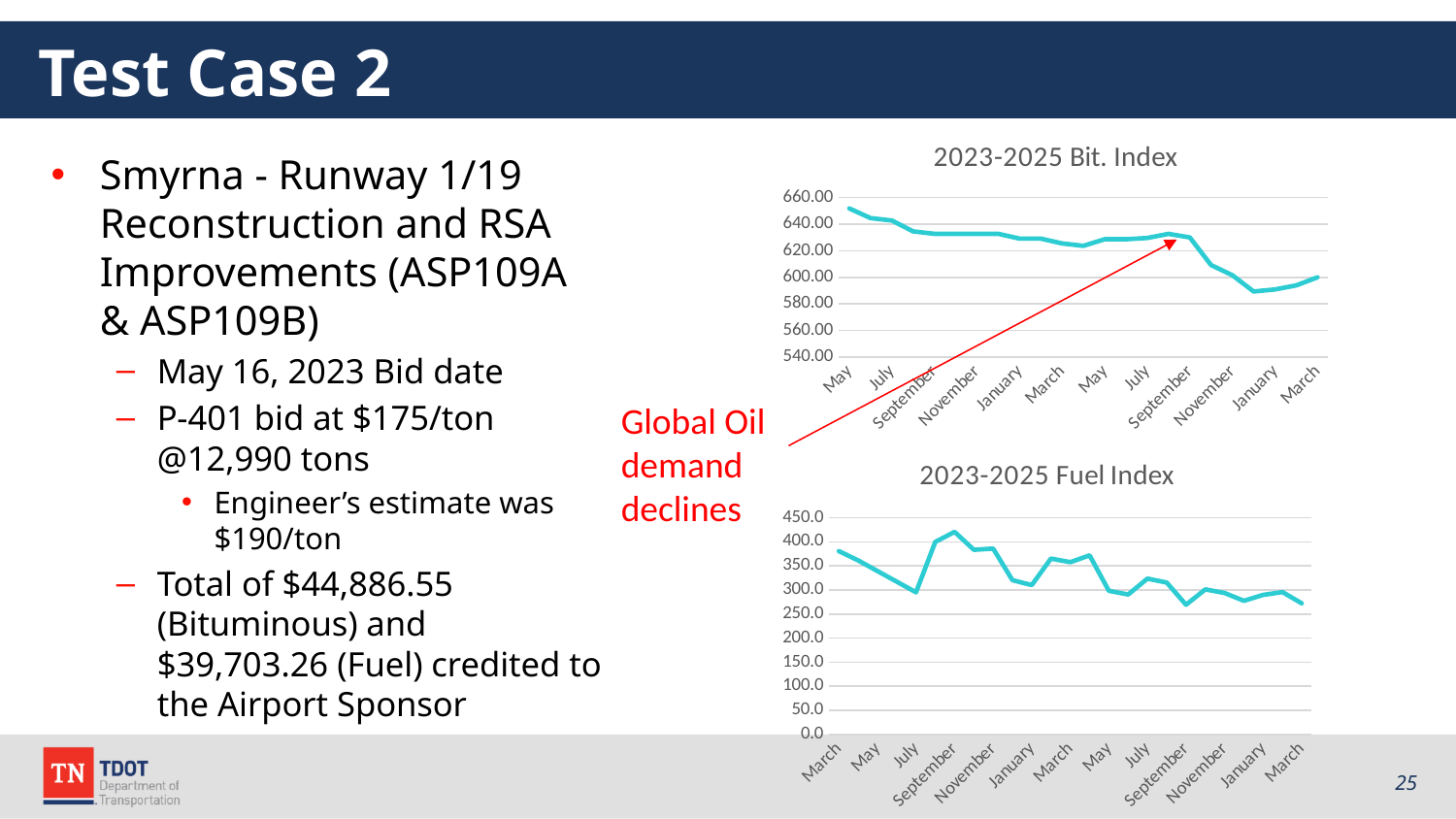
What type of chart is the "2023-2025 Fuel Index" chart? line chart In the "2023-2025 Bit. Index" chart, is the value for the second January greater or less than 600.00? less In the "2023-2025 Fuel Index" chart, which labeled month has the highest value? September (2023) What is the title of the lower chart on the slide? 2023-2025 Fuel Index In the "2023-2025 Fuel Index" chart, is the value for the last March greater or less than 300.0? less In the "2023-2025 Bit. Index" chart, is the value for the first May greater or less than 640.00? greater What type of chart is the "2023-2025 Bit. Index" chart? line chart What is the title of the upper chart on the slide? 2023-2025 Bit. Index In the "2023-2025 Bit. Index" chart, do the values overall rise or fall from left to right? fall In the "2023-2025 Bit. Index" chart, which is larger: the value for the first May or the value for the second January? the first May In the "2023-2025 Fuel Index" chart, do the values overall rise or fall from left to right? fall